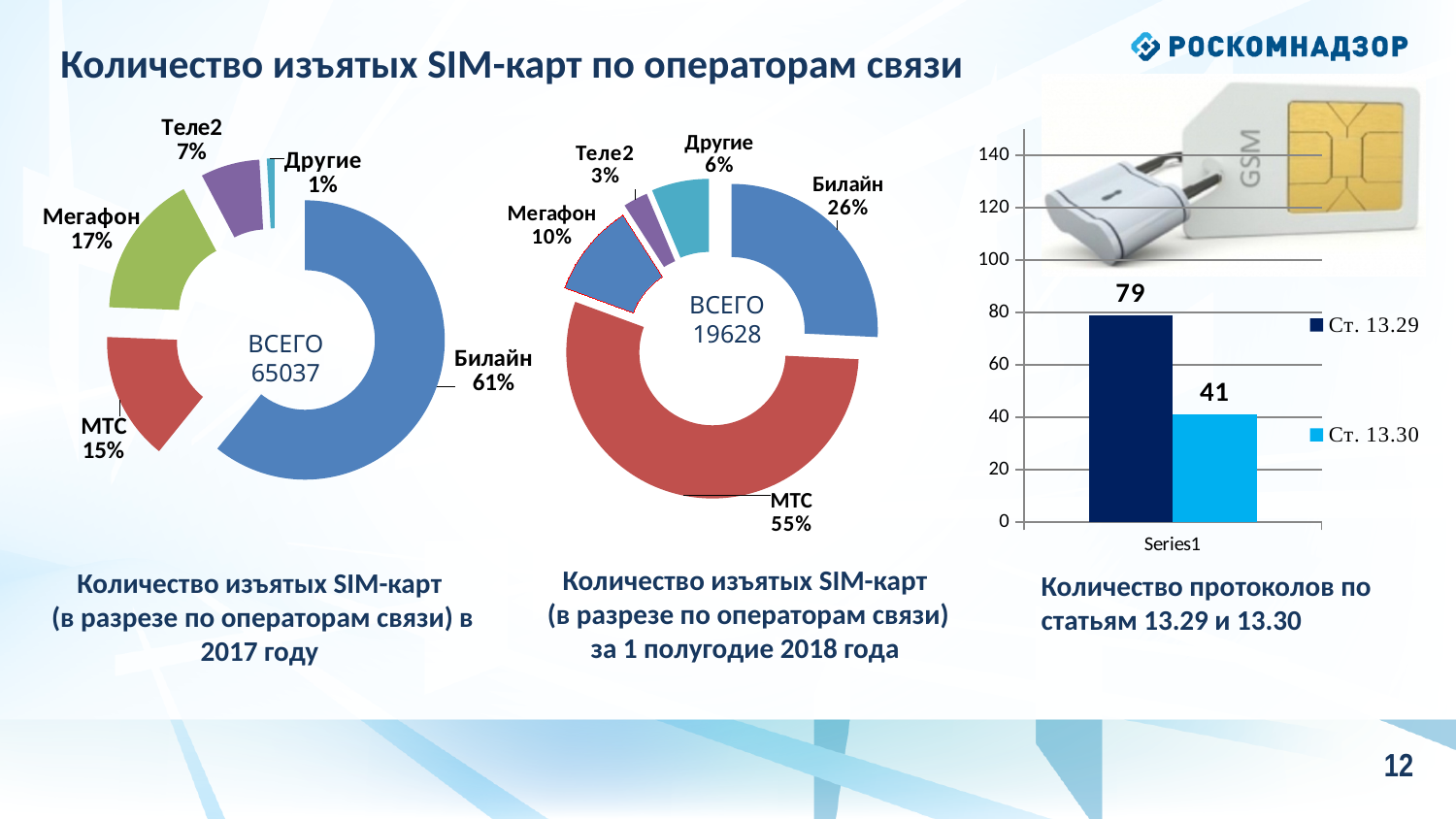
In the bar chart on the right, how many series does the legend list? 2 In the 2017 donut chart (left), what share of seized SIM cards belongs to Билайн? 61% In the 2017 donut chart (left), what is the total number of seized SIM cards shown in the centre? 65037 In the 2017 donut chart (left), how many operator categories are shown? 5 In the bar chart on the right (Количество протоколов по статьям 13.29 и 13.30), what is the value for Ст. 13.29? 79 In the 1st half 2018 donut chart (middle), what total is shown in the centre? 19628 In the 1st half 2018 donut chart (middle), which operator has the largest share? МТС In the 1st half 2018 donut chart (middle), what is the difference in percentage points between МТС and Билайн? 29 In the bar chart on the right, what is the difference between the values for Ст. 13.29 and Ст. 13.30? 38 In the 1st half 2018 donut chart (middle), what share belongs to Мегафон? 10% In the 2017 donut chart (left), which operator has the smallest share? Другие What type of chart is the chart on the right of the slide? Bar chart